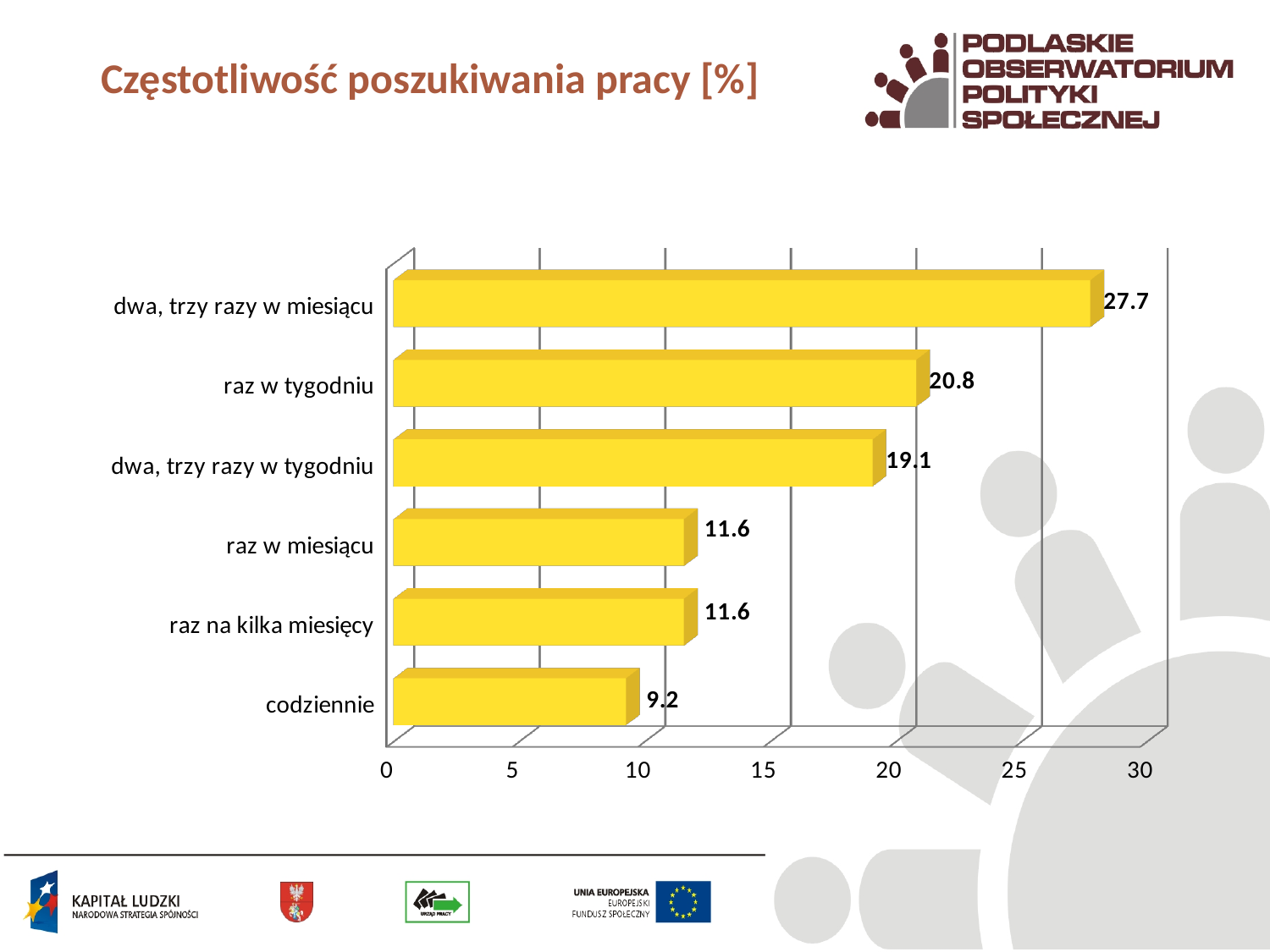
Which is larger: the value for "raz w tygodniu" or the value for "dwa, trzy razy w tygodniu"? raz w tygodniu What is the difference between the values for "dwa, trzy razy w miesiącu" and "raz w tygodniu"? 6.9 How many categories are shown in the chart? 6 Which category has the highest value? dwa, trzy razy w miesiącu What is the value for "codziennie"? 9.2 What is the value for "dwa, trzy razy w miesiącu"? 27.7 What is the value for "raz w tygodniu"? 20.8 What is the title of the chart on the slide? Częstotliwość poszukiwania pracy [%] Which category has the lowest value? codziennie Is the value for "raz w miesiącu" greater or less than 10? greater What kind of chart is shown on the slide? bar chart What is the value for "dwa, trzy razy w tygodniu"? 19.1